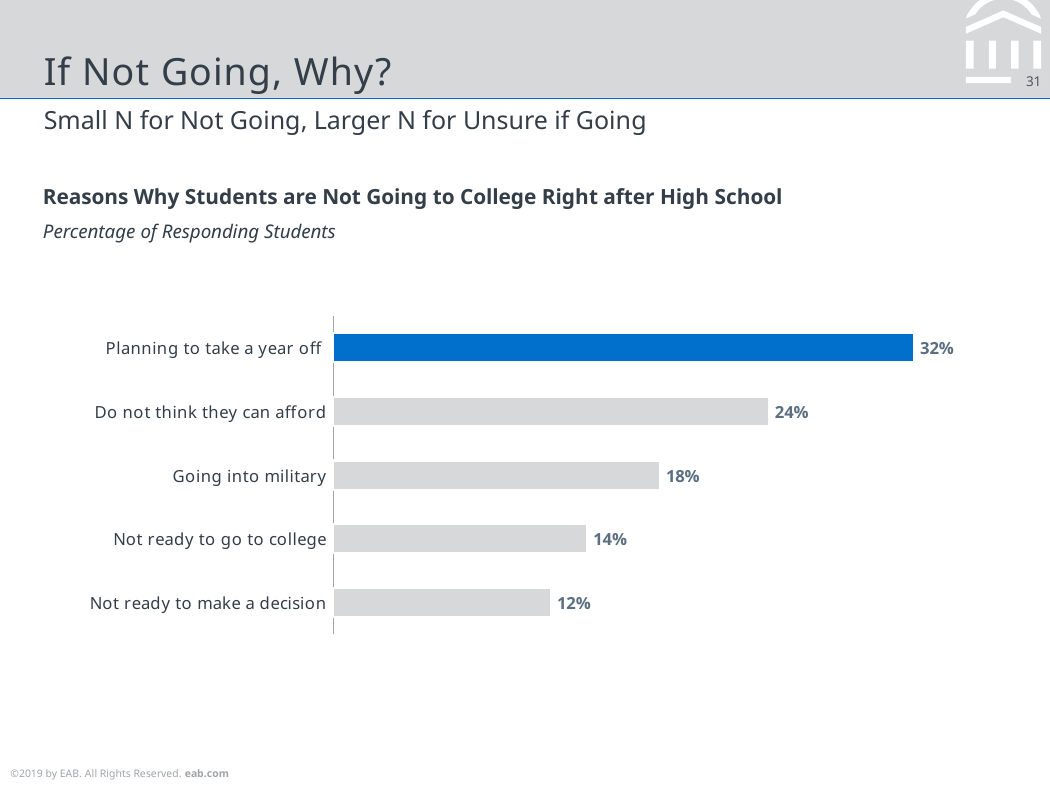
What percentage of responding students do not think they can afford college? 24% What percentage of responding students are not ready to make a decision? 12% What percentage of responding students are planning to take a year off? 32% What percentage of responding students are going into the military? 18% What is the difference in percentage points between 'Going into military' and 'Not ready to go to college'? 4 Which reason has the lowest percentage of responding students? Not ready to make a decision What is the title of the chart? Reasons Why Students are Not Going to College Right after High School What type of chart is shown on the slide? Bar chart How many reasons are shown in the chart? 5 Which has a larger percentage: 'Not ready to go to college' or 'Not ready to make a decision'? Not ready to go to college Which reason has the highest percentage of responding students? Planning to take a year off What is the difference in percentage points between 'Planning to take a year off' and 'Do not think they can afford'? 8